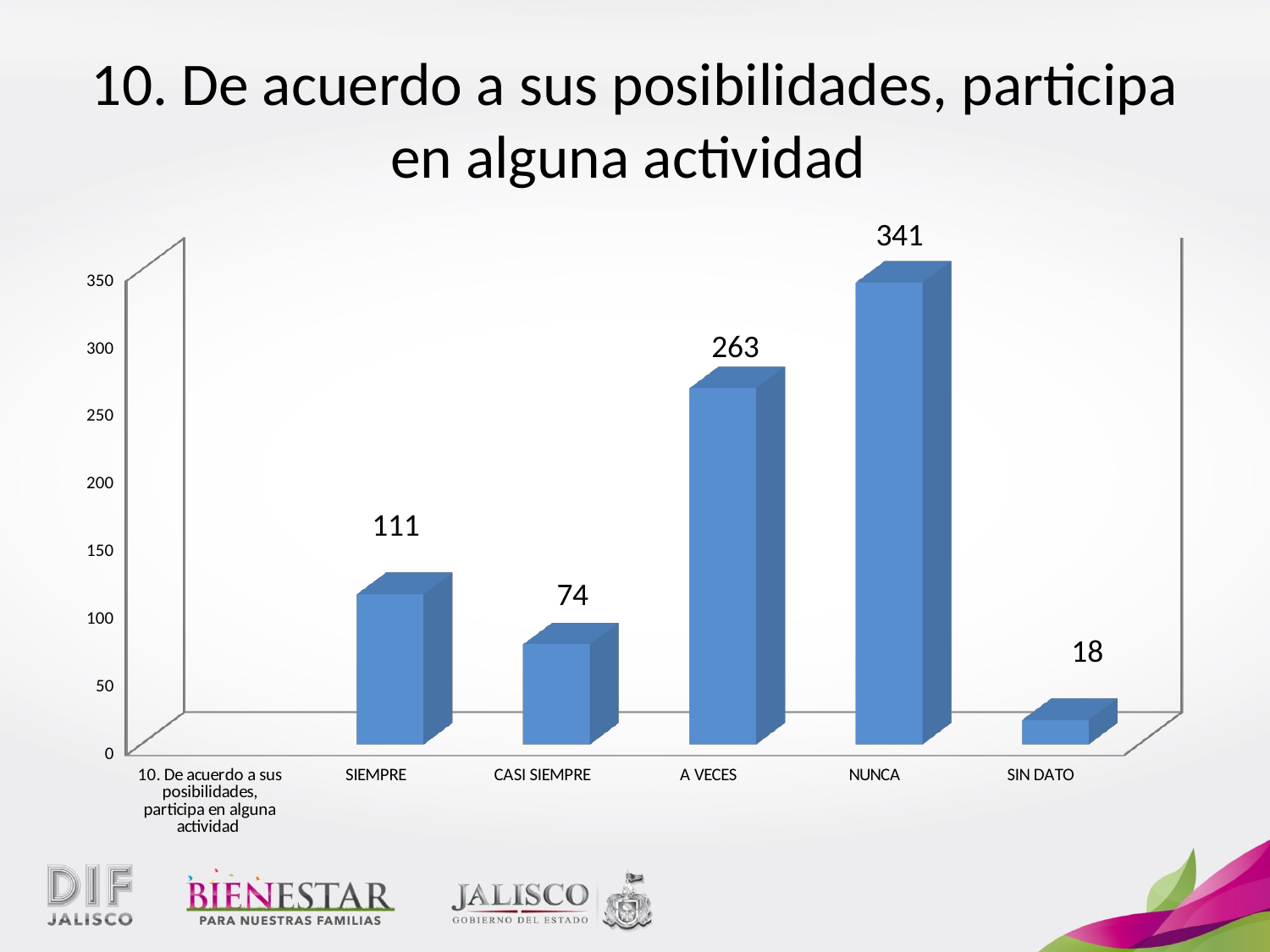
Which category has the highest value? NUNCA What is the value for SIN DATO? 18 How many bars are plotted in the chart? 5 What is the difference between the values for NUNCA and A VECES? 78 What is the value for A VECES? 263 Which category has the lowest value? SIN DATO Which is larger, the value for SIEMPRE or the value for CASI SIEMPRE? SIEMPRE What is the difference between the values for SIEMPRE and CASI SIEMPRE? 37 What kind of chart is shown on the slide? bar chart What is the value for NUNCA? 341 Is the value for A VECES greater or less than 250? greater What is the value for CASI SIEMPRE? 74